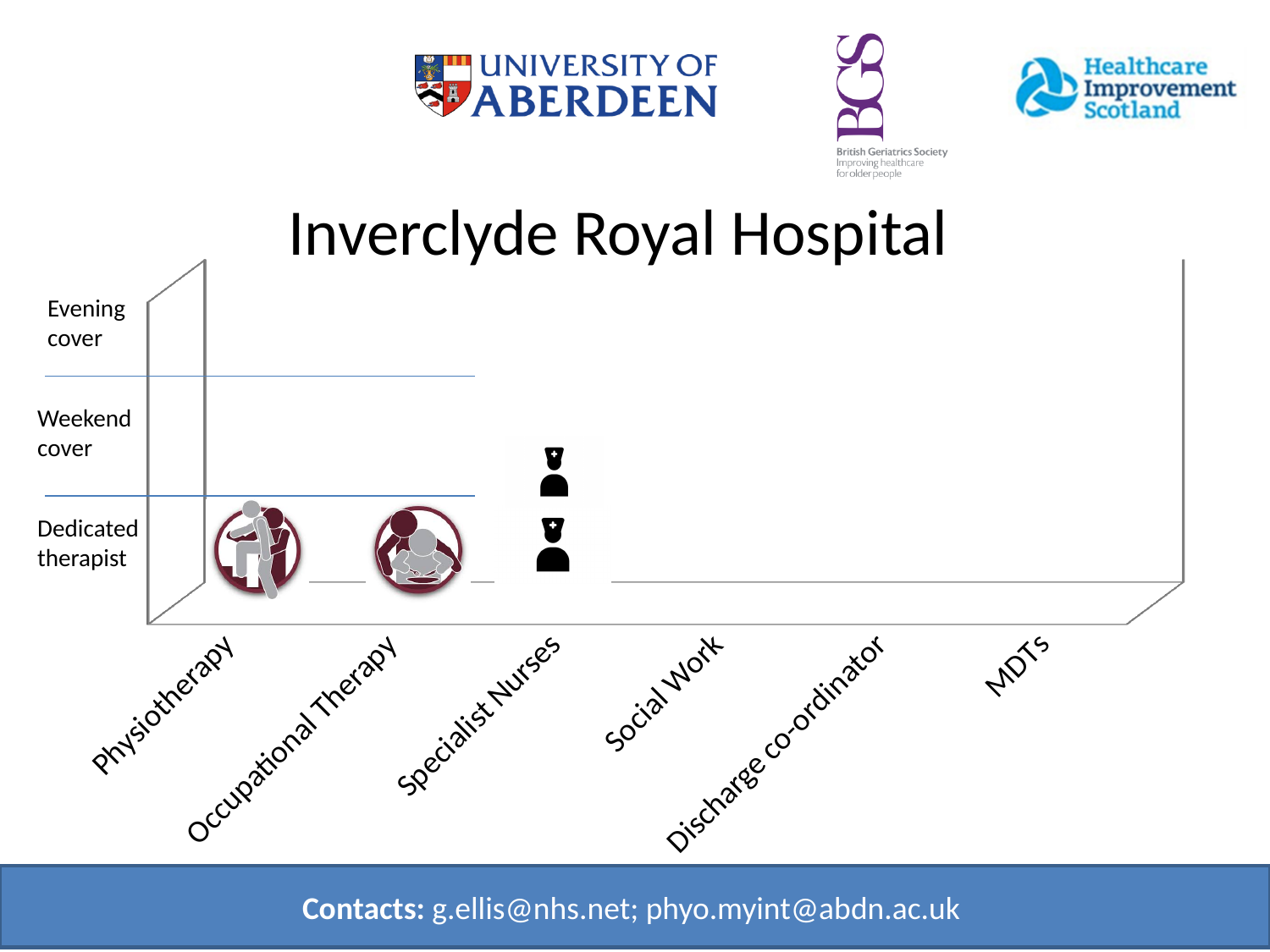
How many categories are shown along the x axis of the chart? 6 Does any category reach the Evening cover level in the chart? No How many levels are labelled on the vertical axis of the chart? 3 Which vertical-axis level does the Physiotherapy icon sit in? Dedicated therapist What is the title of the chart on the slide? Inverclyde Royal Hospital Which category has the most icons stacked in the chart? Specialist Nurses What is the label of the first category on the x axis? Physiotherapy How many nurse icons are shown for Specialist Nurses? 2 Which categories have no icons plotted in the chart? Social Work, Discharge co-ordinator, MDTs Which vertical-axis level does the Specialist Nurses stack reach up to? Weekend cover What is the label of the last category on the x axis? MDTs Does Specialist Nurses or Occupational Therapy have more icons in the chart? Specialist Nurses